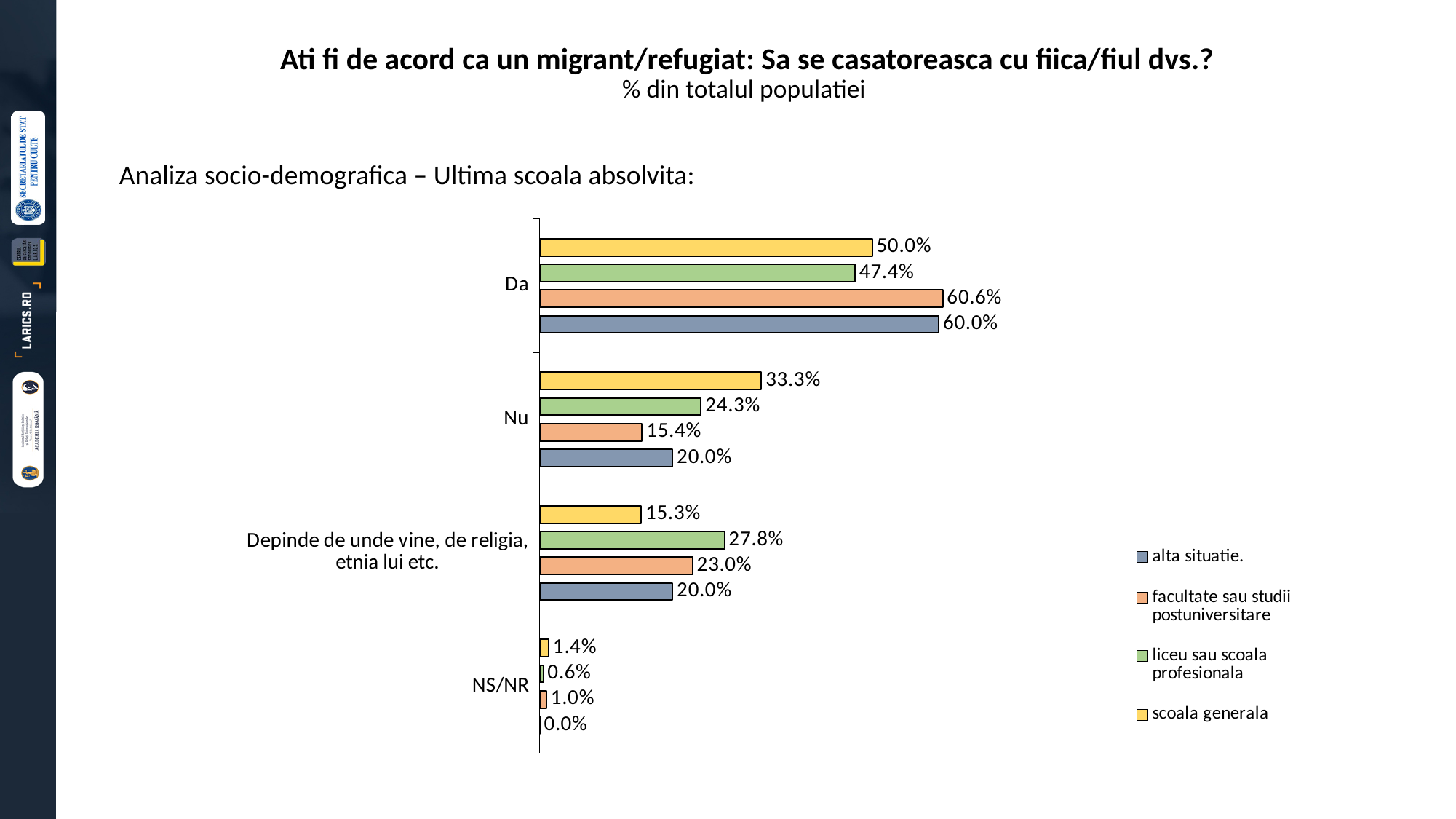
What is the value for 'liceu sau scoala profesionala' in the 'Depinde de unde vine, de religia, etnia lui etc.' category? 27.8% What colour represents 'scoala generala' in the chart? yellow How many series does the legend list? 4 What kind of chart is shown on the slide? bar chart What is the value for 'alta situatie.' in the 'NS/NR' category? 0.0% In the 'Depinde de unde vine, de religia, etnia lui etc.' category, which is larger: 'scoala generala' or 'facultate sau studii postuniversitare'? facultate sau studii postuniversitare Which series has the highest value in the 'Da' category? facultate sau studii postuniversitare How many response categories are shown on the chart? 4 Which series has the lowest value in the 'Nu' category? facultate sau studii postuniversitare What is the value for 'facultate sau studii postuniversitare' in the 'Nu' category? 15.4% What is the value for 'scoala generala' in the 'Da' category? 50.0% What is the difference between the 'scoala generala' and 'liceu sau scoala profesionala' values in the 'Nu' category? 9.0%